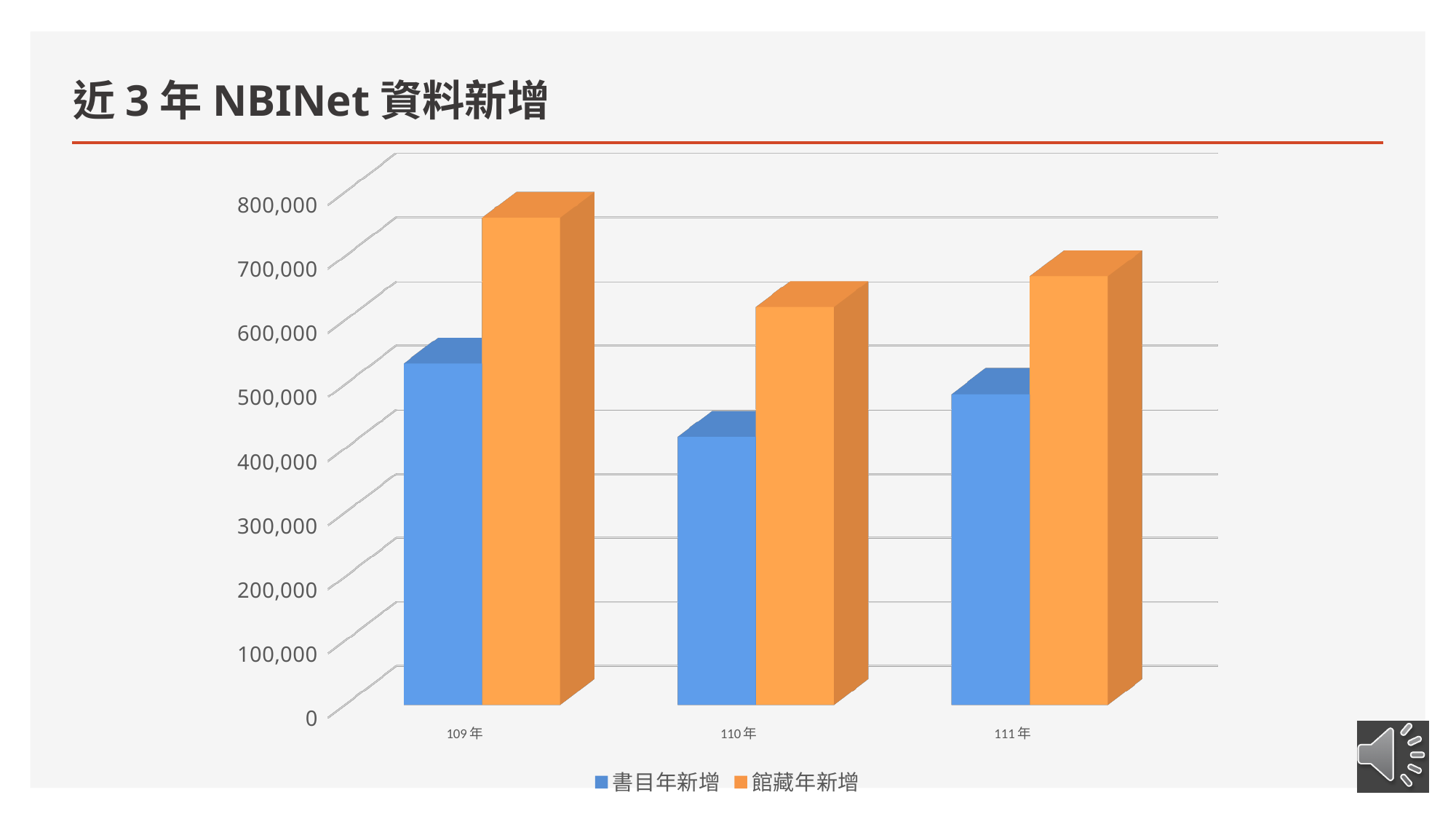
In 109年, which is larger: 書目年新增 or 館藏年新增? 館藏年新增 In which year is 書目年新增 the lowest? 110年 Is the value for 館藏年新增 in 111年 greater or less than 600,000? greater In which year is 館藏年新增 the highest? 109年 Is the value for 館藏年新增 in 109年 greater or less than 700,000? greater Is the value for 館藏年新增 in 110年 greater or less than 700,000? less How many series does the legend list? 2 How many year categories are shown on the x axis? 3 What type of chart is shown on the slide? bar chart Does 書目年新增 rise or fall from 109年 to 110年? fall Which colour represents 館藏年新增 in the legend? orange